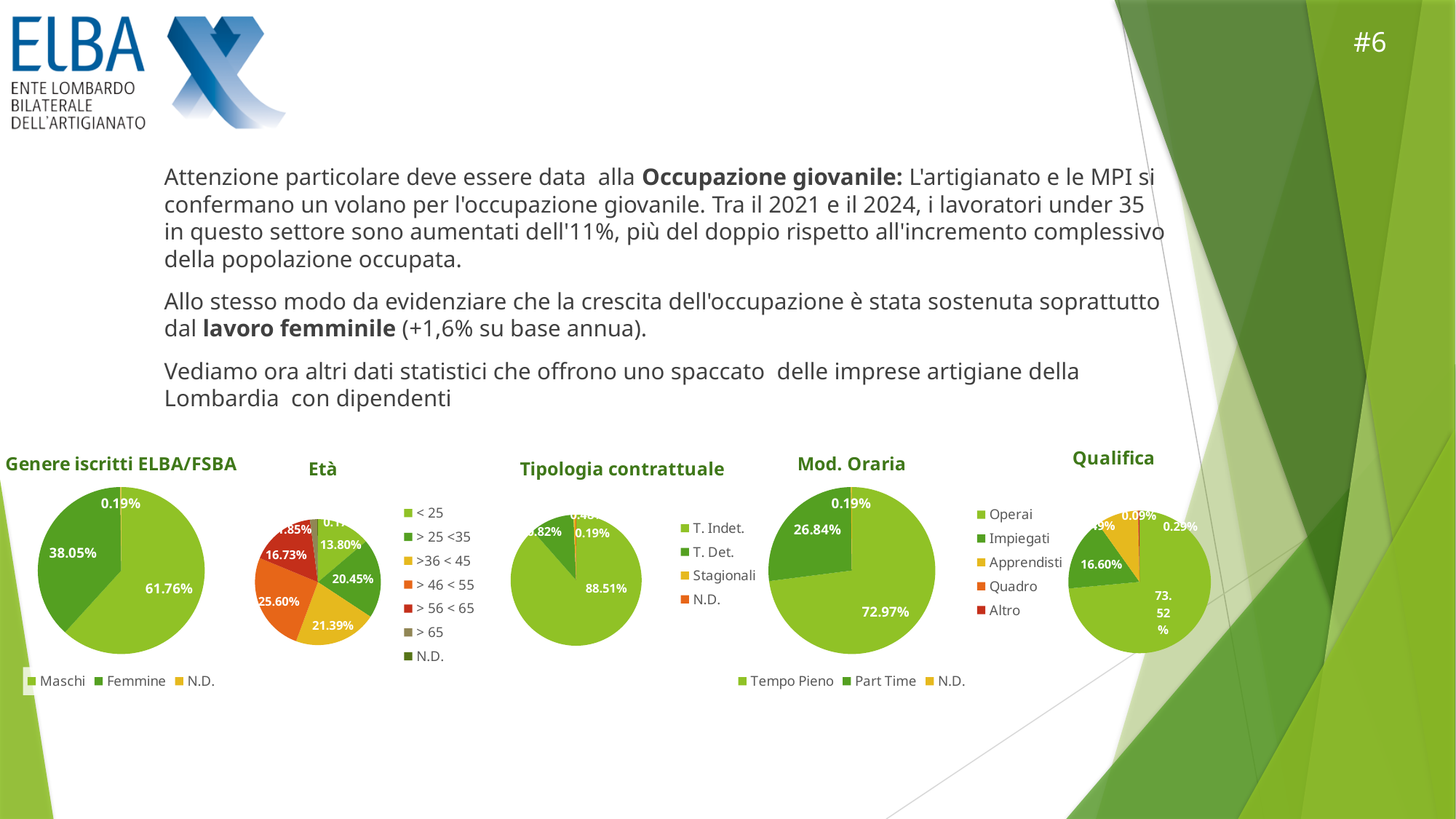
In the 'Genere iscritti ELBA/FSBA' chart, which category has the largest slice? Maschi In the 'Mod. Oraria' chart, what percentage is shown for Part Time? 26.84% In the 'Età' chart, which age group has the largest slice? > 46 < 55 What type of chart is used for 'Mod. Oraria'? Pie chart In the 'Qualifica' chart, which is larger, Operai or Impiegati? Operai In the 'Qualifica' chart, what percentage is shown for Impiegati? 16.60% In the 'Età' chart, what percentage is shown for the '> 46 < 55' age group? 25.60% In the 'Genere iscritti ELBA/FSBA' chart, what percentage is shown for Maschi? 61.76% In the 'Genere iscritti ELBA/FSBA' chart, what is the difference in percentage points between Maschi and Femmine? 23.71% How many entries does the legend of the 'Età' chart list? 7 In the 'Tipologia contrattuale' chart, what percentage is shown for T. Indet.? 88.51% In the 'Mod. Oraria' chart, what is the difference in percentage points between Tempo Pieno and Part Time? 46.13%